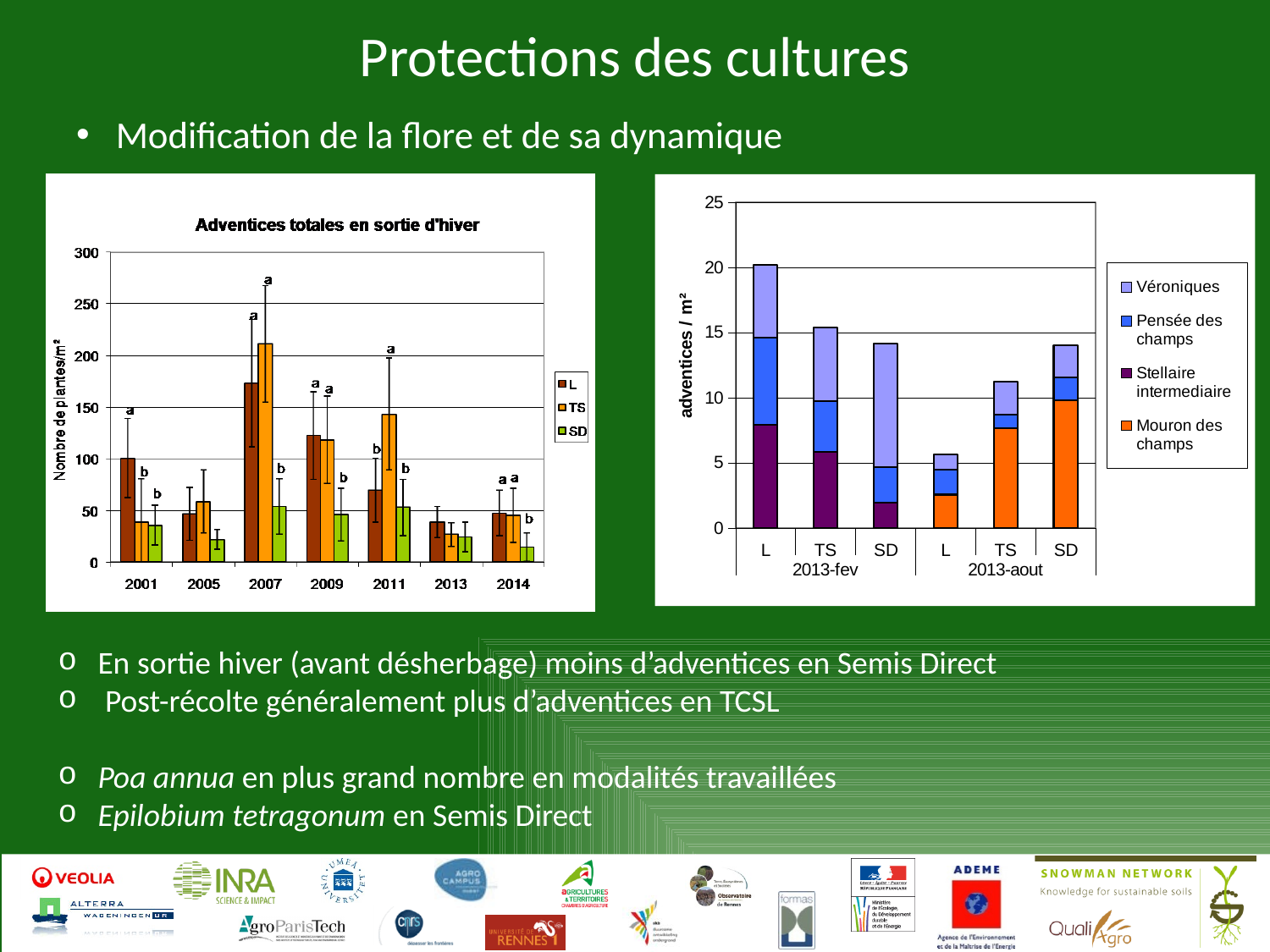
What kind of chart is the left chart titled 'Adventices totales en sortie d'hiver'? bar chart In the left chart 'Adventices totales en sortie d'hiver', is the value for SD in 2014 greater or less than 50? less In the right chart, is the total for L in 2013-aout greater or less than 10? less In the left chart 'Adventices totales en sortie d'hiver', is the value for L in 2007 greater or less than 150? greater In the left chart 'Adventices totales en sortie d'hiver', in which year is the TS bar highest? 2007 In the left chart 'Adventices totales en sortie d'hiver', how many series does the legend list? 3 In the left chart 'Adventices totales en sortie d'hiver', how many years are shown on the x axis? 7 In the left chart 'Adventices totales en sortie d'hiver', which is larger in 2001, L or SD? L In the right chart, how many series does the legend list? 4 In the left chart 'Adventices totales en sortie d'hiver', what is the label of the y axis? Nombre de plantes/m² What kind of chart is the right chart? stacked bar chart In the right chart, which bar has the highest total? L in 2013-fev